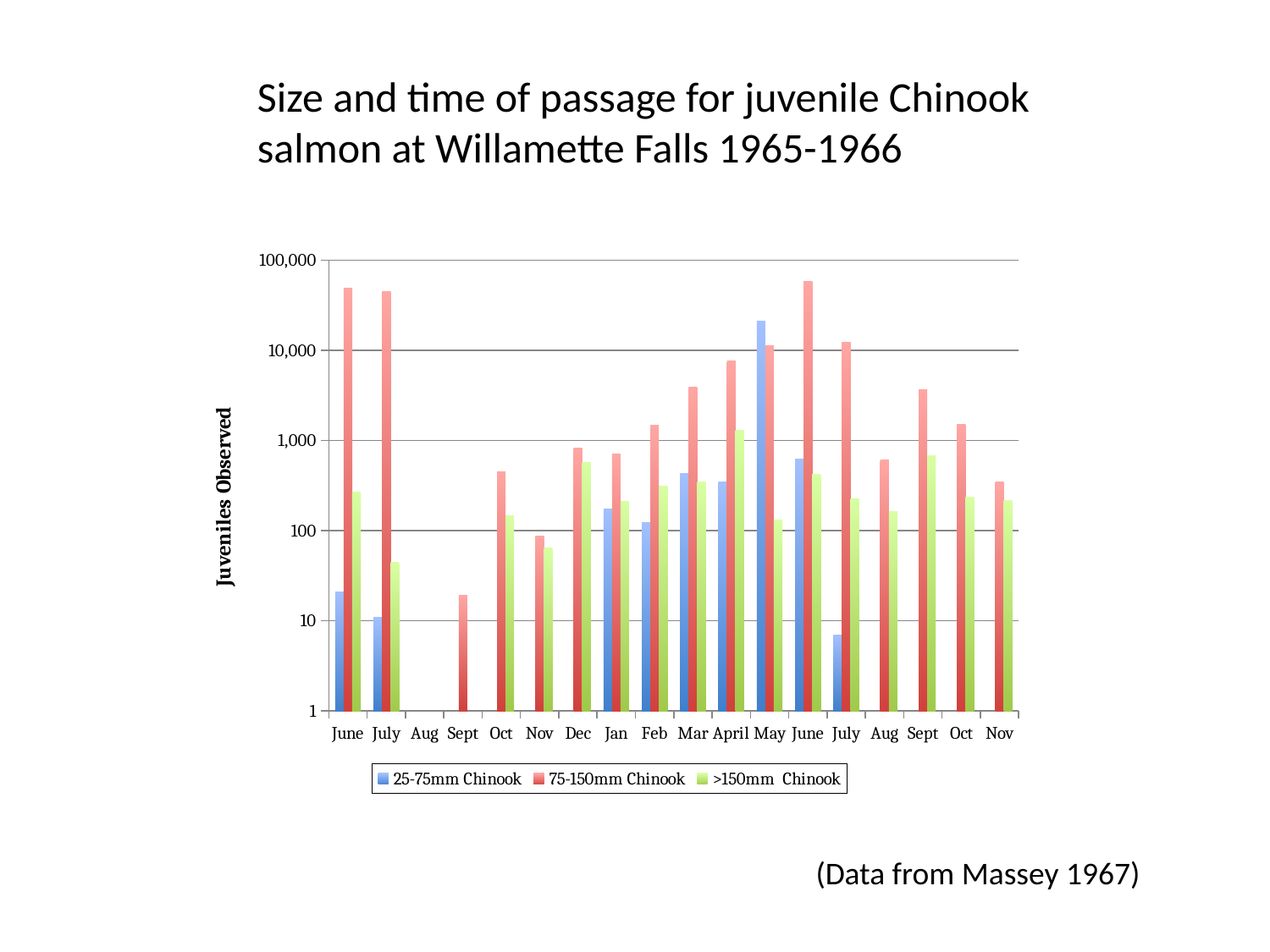
Is the value for 75-150mm Chinook in the first Sept greater or less than 100? less What is the label on the y axis? Juveniles Observed How many series does the legend list? 3 In May, which series has the larger value: 25-75mm Chinook or 75-150mm Chinook? 25-75mm Chinook Is the value for 25-75mm Chinook in May greater or less than 10,000? greater In Jan, which series has the larger value: 75-150mm Chinook or >150mm Chinook? 75-150mm Chinook Which month has the highest value for the 25-75mm Chinook series? May What kind of chart is shown on the slide? Bar chart Which month has the highest value for the >150mm Chinook series? April What is the title of the chart? Size and time of passage for juvenile Chinook salmon at Willamette Falls 1965-1966 Is the value for 75-150mm Chinook in Mar greater or less than 1,000? greater How many month categories are shown along the x axis? 18